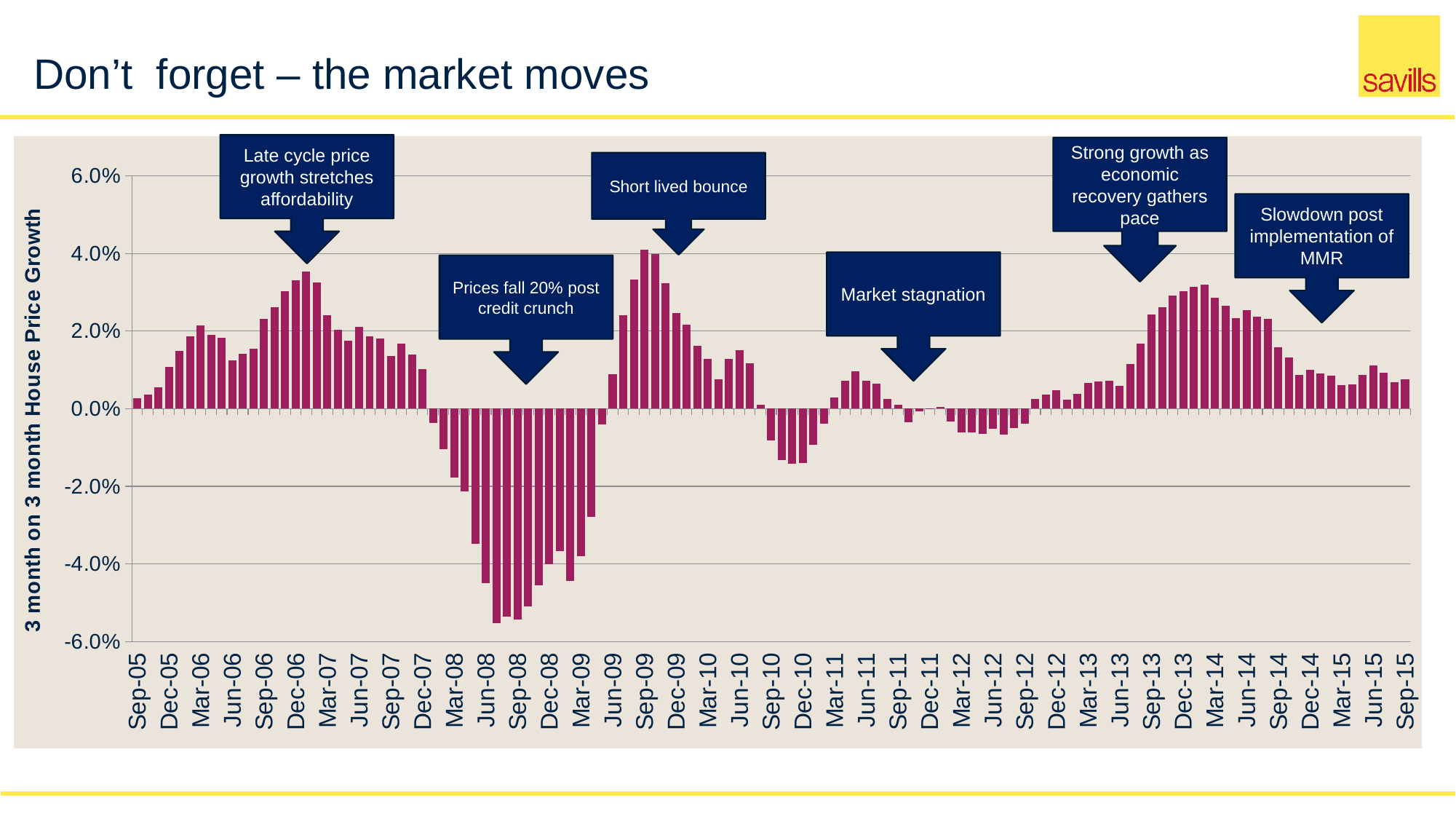
Is the value for Mar-14 greater or less than 2.0%? greater Which is larger, the value for Sep-09 or the value for Dec-06? Sep-09 What is the label on the vertical axis of the chart? 3 month on 3 month House Price Growth Do the values generally rise or fall from Mar-14 to Sep-15? Fall Is the value for Dec-06 greater or less than 2.0%? greater Is the value for Sep-08 greater or less than -4.0%? less What kind of chart is shown on the slide? Bar chart What is the title of the slide containing the chart? Don't forget – the market moves Which is lower, the value for Sep-08 or the value for Mar-09? Sep-08